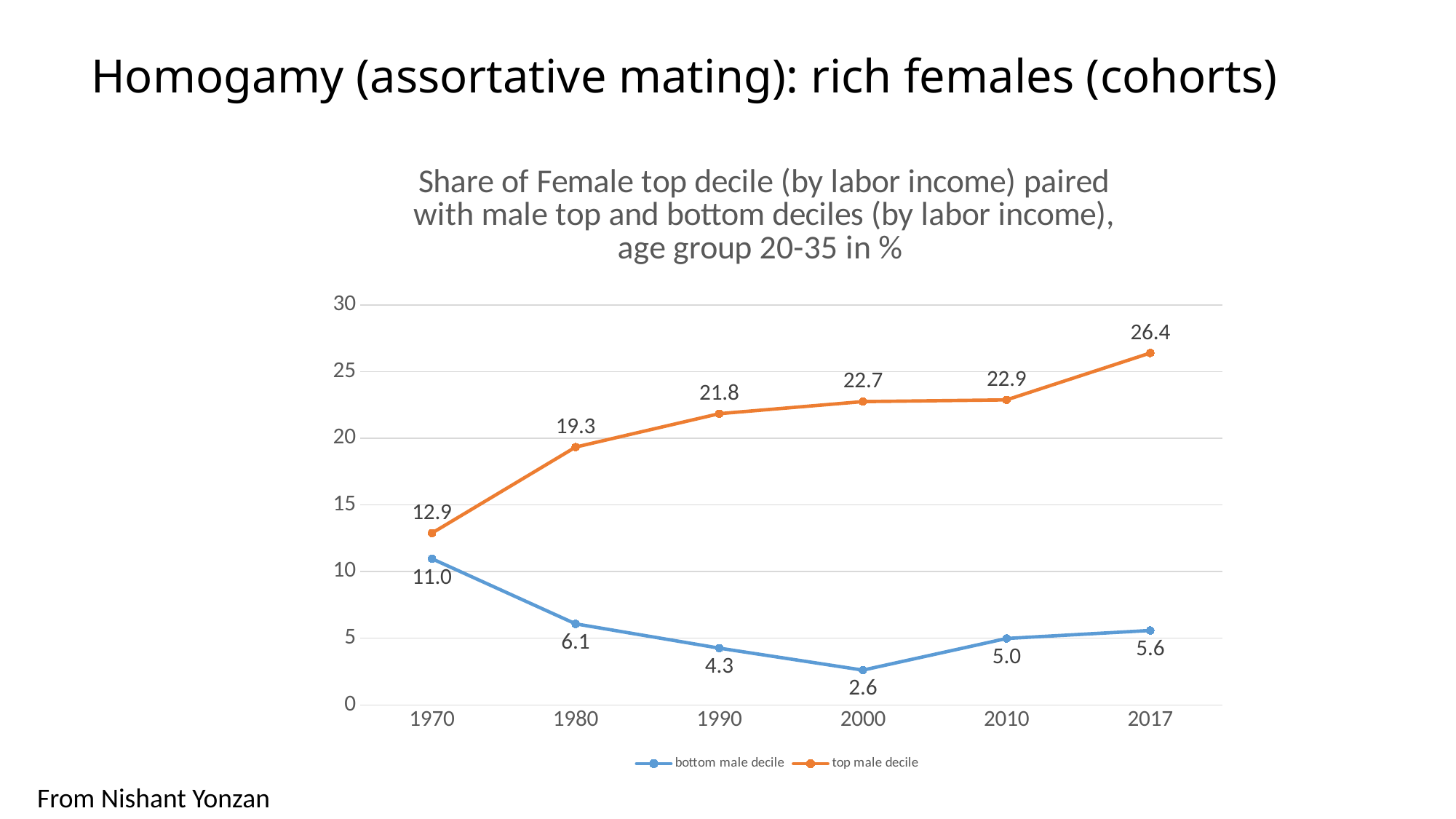
What kind of chart is shown on the slide? line chart What is the value for top male decile in 1970? 12.9 In which year is the top male decile series highest? 2017 What is the difference between the top male decile values in 2017 and 2010? 3.5 How many years are shown on the x axis? 6 In which year is the bottom male decile series lowest? 2000 What is the value for bottom male decile in 2000? 2.6 How many series does the legend list? 2 Does the top male decile series rise or fall from 1970 to 2017? rise What is the value for top male decile in 2017? 26.4 What is the difference between the top male decile and bottom male decile values in 1970? 1.9 Which is larger in 1980: the top male decile value or the bottom male decile value? top male decile